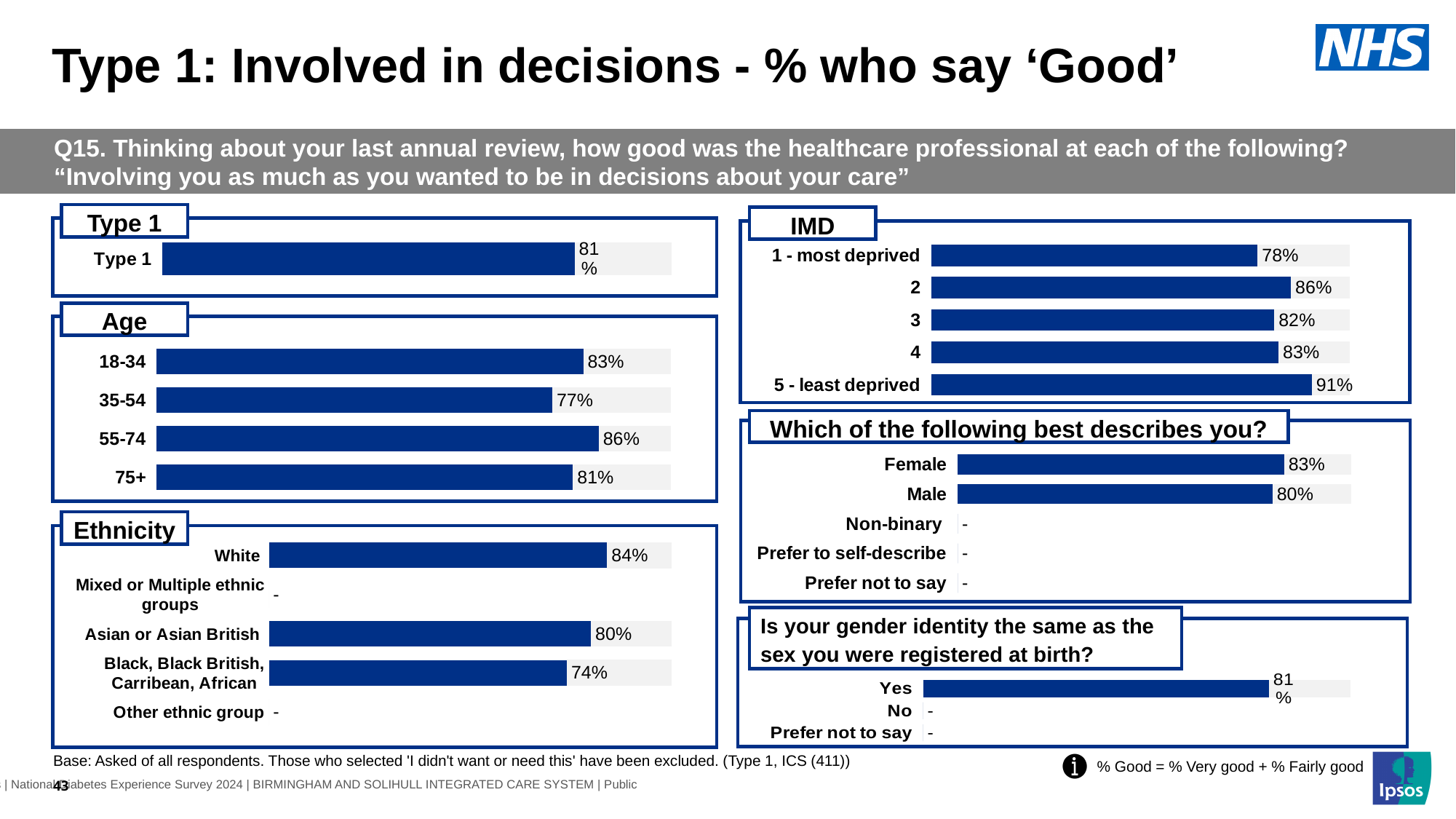
In the 'Which of the following best describes you?' chart, which is larger, Female or Male? Female In the IMD chart, how many IMD categories are shown? 5 In the Age chart, what is the difference between the 55-74 and 35-54 values? 9 percentage points In the Ethnicity chart, which ethnic group with a plotted value has the lowest value? Black, Black British, Carribean, African In the 'Is your gender identity the same as the sex you were registered at birth?' chart, what is the value for Yes? 81% What type of chart is used in the Age section? Bar chart In the Type 1 chart, what percentage of Type 1 respondents say 'Good'? 81% In the Age chart, which age group has the highest value? 55-74 In the Age chart, what is the value for the 35-54 age group? 77% In the IMD chart, what is the value for 5 - least deprived? 91% In the Ethnicity chart, what is the value for Black, Black British, Carribean, African? 74% In the IMD chart, which IMD group has the lowest value? 1 - most deprived